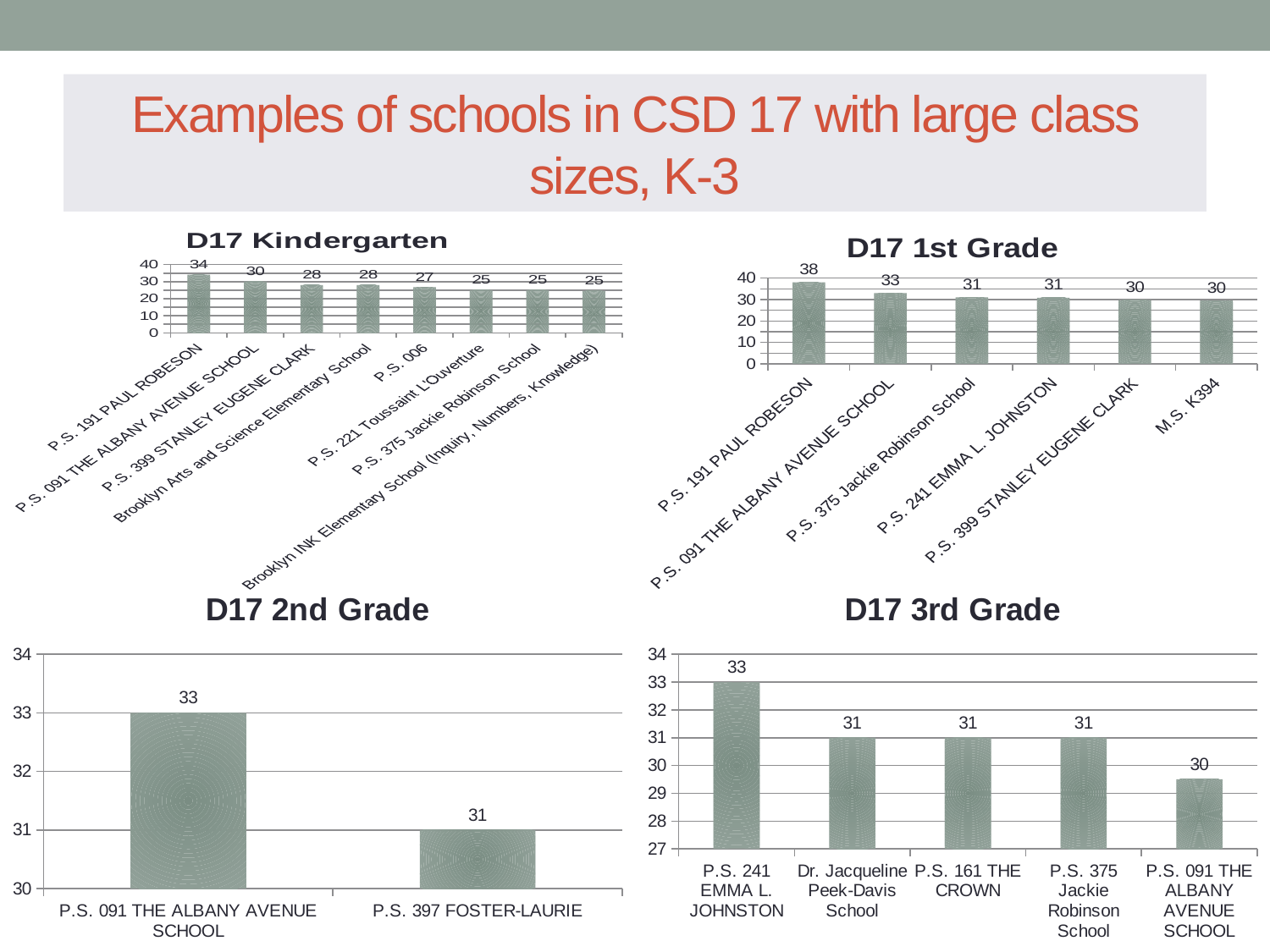
In the D17 1st Grade chart, which is larger, P.S. 191 PAUL ROBESON or P.S. 091 THE ALBANY AVENUE SCHOOL? P.S. 191 PAUL ROBESON In the D17 1st Grade chart, what is the value for M.S. K394? 30 In the D17 2nd Grade chart, what is the value for P.S. 397 FOSTER-LAURIE? 31 In the D17 Kindergarten chart, what is the difference between P.S. 191 PAUL ROBESON and P.S. 006? 7 In the D17 1st Grade chart, how many schools are shown? 6 In the D17 2nd Grade chart, what is the difference between P.S. 091 THE ALBANY AVENUE SCHOOL and P.S. 397 FOSTER-LAURIE? 2 In the D17 Kindergarten chart, how many schools are shown? 8 In the D17 1st Grade chart, which school has the highest value? P.S. 191 PAUL ROBESON In the D17 3rd Grade chart, which school has the lowest value? P.S. 091 THE ALBANY AVENUE SCHOOL In the D17 3rd Grade chart, what is the value for P.S. 241 EMMA L. JOHNSTON? 33 In the D17 Kindergarten chart, what is the value for P.S. 191 PAUL ROBESON? 34 What kind of chart is the D17 3rd Grade chart? Bar chart